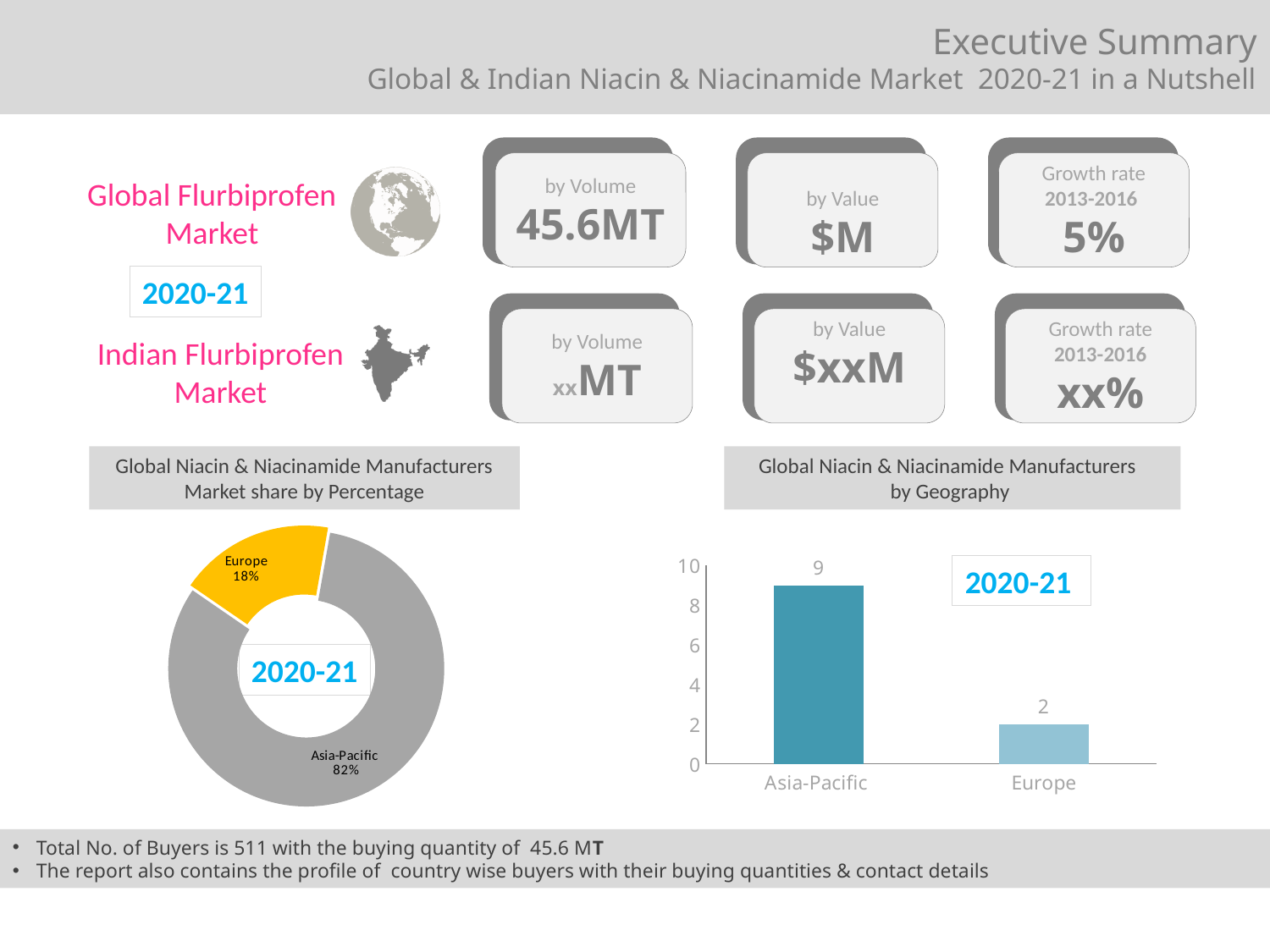
In the 'Global Niacin & Niacinamide Manufacturers by Geography' chart, what is the difference between the Asia-Pacific and Europe values? 7 In the 'Global Niacin & Niacinamide Manufacturers by Geography' chart, which region has the lowest value? Europe What kind of chart is the 'Global Niacin & Niacinamide Manufacturers Market share by Percentage' chart? Doughnut (pie) chart In the 'Global Niacin & Niacinamide Manufacturers by Geography' chart, what is the value for Asia-Pacific? 9 In the 'Global Niacin & Niacinamide Manufacturers by Geography' chart, is the value for Asia-Pacific greater or less than 8? greater In the 'Global Niacin & Niacinamide Manufacturers by Geography' chart, what is the value for Europe? 2 In the 'Global Niacin & Niacinamide Manufacturers Market share by Percentage' chart, which region has the largest share? Asia-Pacific What kind of chart is the 'Global Niacin & Niacinamide Manufacturers by Geography' chart? Bar chart In the 'Global Niacin & Niacinamide Manufacturers Market share by Percentage' chart, what share does Europe hold? 18% In the 'Global Niacin & Niacinamide Manufacturers Market share by Percentage' chart, what share does Asia-Pacific hold? 82% In the 'Global Niacin & Niacinamide Manufacturers Market share by Percentage' chart, how many slices are shown? 2 In the 'Global Niacin & Niacinamide Manufacturers by Geography' chart, what is the maximum value shown on the vertical axis? 10